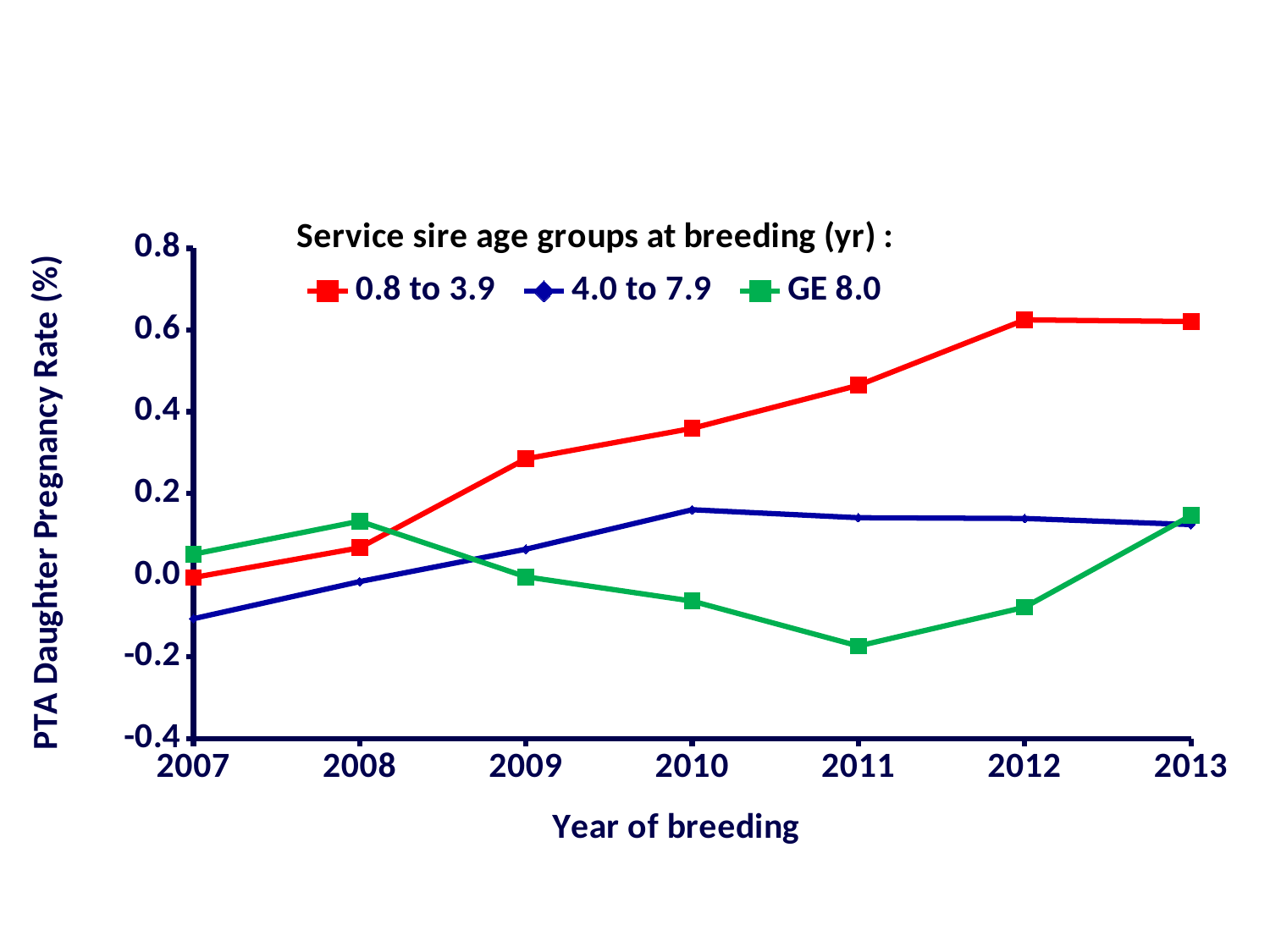
Which series has the larger value in 2012, 4.0 to 7.9 or GE 8.0? 4.0 to 7.9 Which series has the larger value in 2010, 0.8 to 3.9 or GE 8.0? 0.8 to 3.9 How many years are plotted along the x axis? 7 Is the value for the GE 8.0 series in 2011 greater or less than 0.0? less What kind of chart is shown on the slide? line chart Is the value for the 4.0 to 7.9 series in 2007 greater or less than 0.0? less How many series does the legend list? 3 Is the value for the 0.8 to 3.9 series in 2011 greater or less than 0.4? greater What colour is the line for the GE 8.0 series? green In which year is the GE 8.0 series at its lowest value? 2011 What is the label of the y axis? PTA Daughter Pregnancy Rate (%) Does the value for the 0.8 to 3.9 series rise or fall from 2007 to 2012? rise